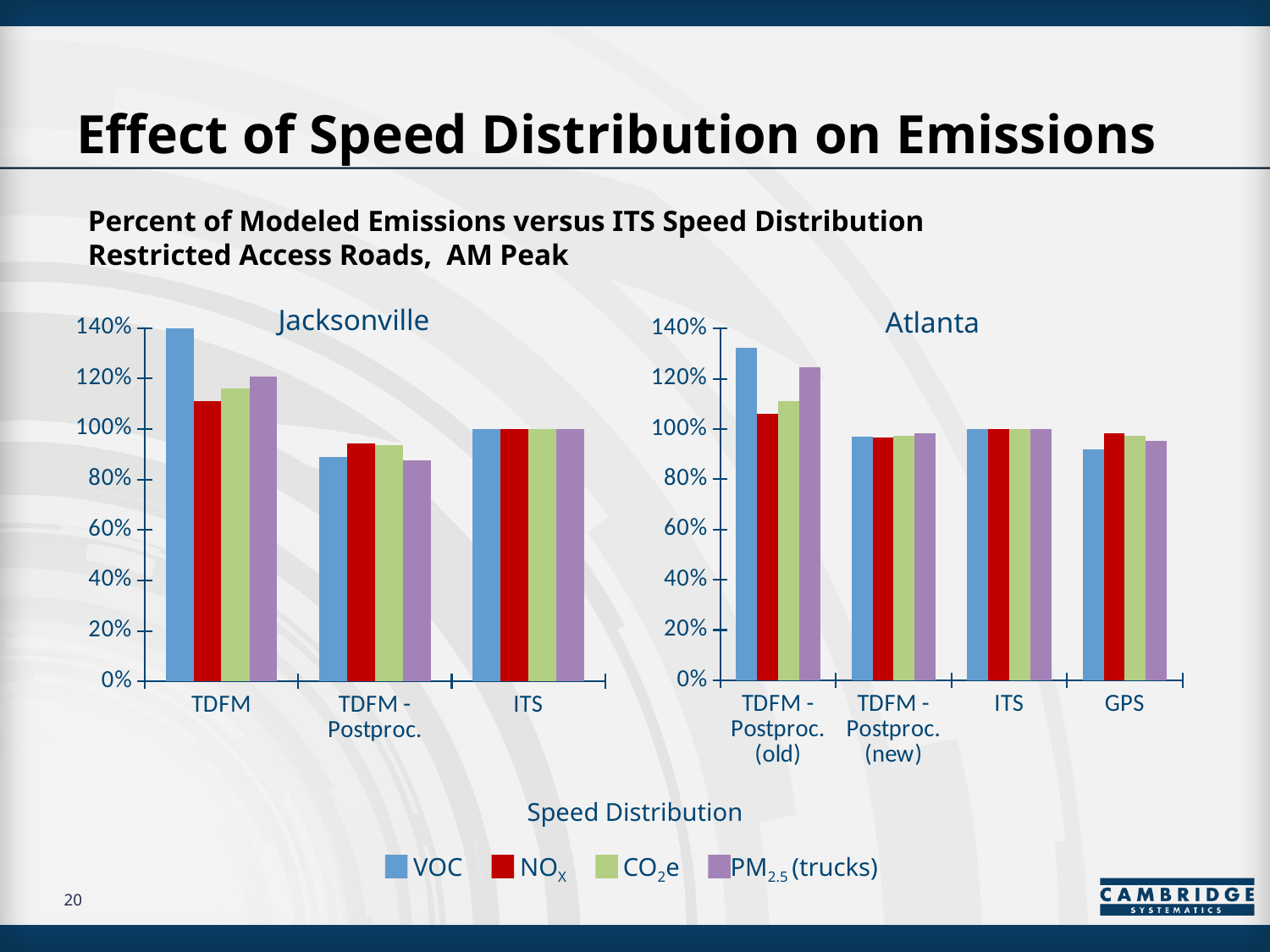
What is the title of the chart on the right? Atlanta In the Atlanta chart, is the VOC value for TDFM - Postproc. (old) greater or less than 120%? greater In the Jacksonville chart, is the VOC value for TDFM greater or less than 120%? greater What kind of chart is the Jacksonville chart? bar chart In the Jacksonville chart, is the VOC value for TDFM - Postproc. greater or less than 100%? less How many categories are shown on the x axis of the Atlanta chart? 4 How many series does the legend list? 4 In the Jacksonville chart, which series has the highest value for TDFM? VOC In the Atlanta chart, which series has the highest value for TDFM - Postproc. (old)? VOC How many categories are shown on the x axis of the Jacksonville chart? 3 In the Jacksonville chart, which is larger for TDFM: the VOC value or the NOx value? VOC